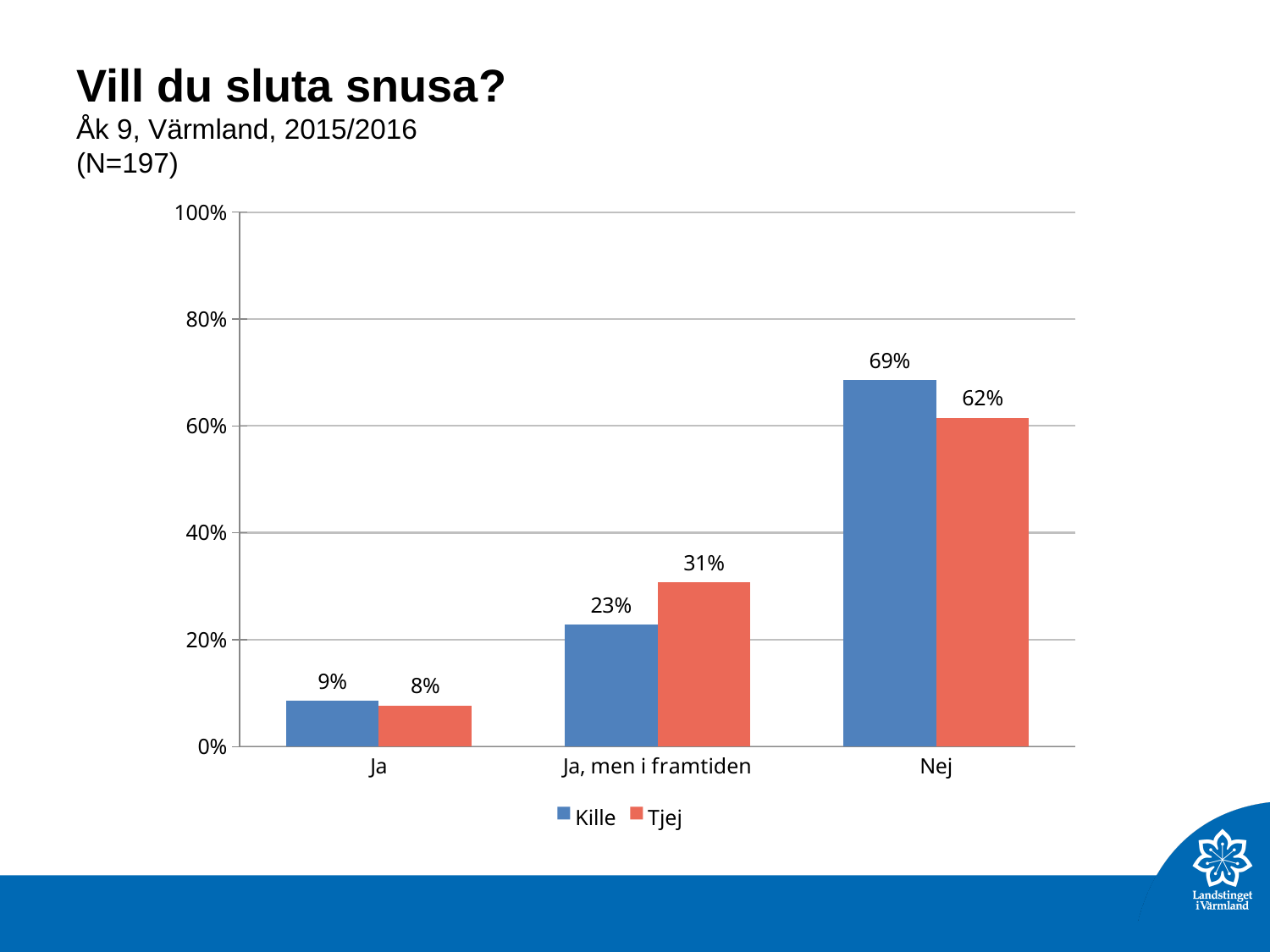
Which category has the highest value for Kille? Nej What kind of chart is shown on the slide? Bar chart Is the value for Tjej in the "Nej" category greater or less than 60%? greater What is the value for Tjej in the "Ja, men i framtiden" category? 31% How many series does the legend list? 2 Which category has the lowest value for Tjej? Ja What is the difference between Kille and Tjej in the "Nej" category? 7% What is the value for Tjej in the "Ja" category? 8% How many categories are shown on the x axis? 3 In the "Ja, men i framtiden" category, which series has the larger value, Kille or Tjej? Tjej What is the difference between Tjej and Kille in the "Ja, men i framtiden" category? 8% What is the value for Kille in the "Nej" category? 69%